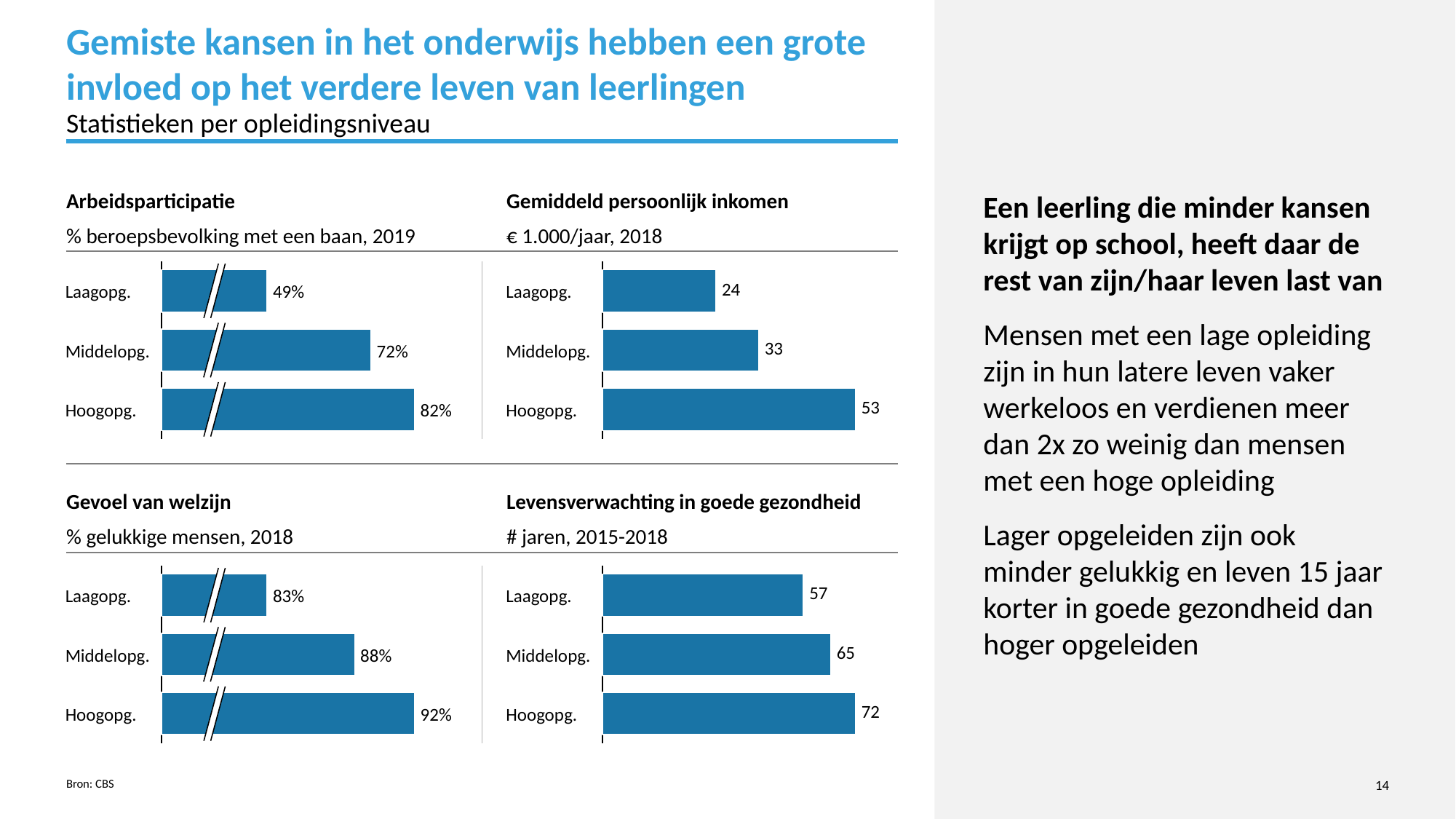
In the 'Levensverwachting in goede gezondheid' chart, what is the difference between Hoogopg. and Laagopg.? 15 In the 'Gemiddeld persoonlijk inkomen' chart, which category has the lowest value? Laagopg. What type of chart is the 'Levensverwachting in goede gezondheid' chart? Bar chart In the 'Arbeidsparticipatie' chart, what is the value for Laagopg.? 49% What is the unit given under the 'Gemiddeld persoonlijk inkomen' chart title? € 1.000/jaar, 2018 In the 'Gemiddeld persoonlijk inkomen' chart, what is the difference between Middelopg. and Laagopg.? 9 In the 'Arbeidsparticipatie' chart, which category has the highest value? Hoogopg. In the 'Levensverwachting in goede gezondheid' chart, what is the value for Laagopg.? 57 In the 'Gevoel van welzijn' chart, what is the value for Middelopg.? 88% In the 'Gevoel van welzijn' chart, which is larger: Laagopg. or Hoogopg.? Hoogopg. In the 'Gemiddeld persoonlijk inkomen' chart, what is the value for Hoogopg.? 53 How many categories does the 'Arbeidsparticipatie' chart show? 3